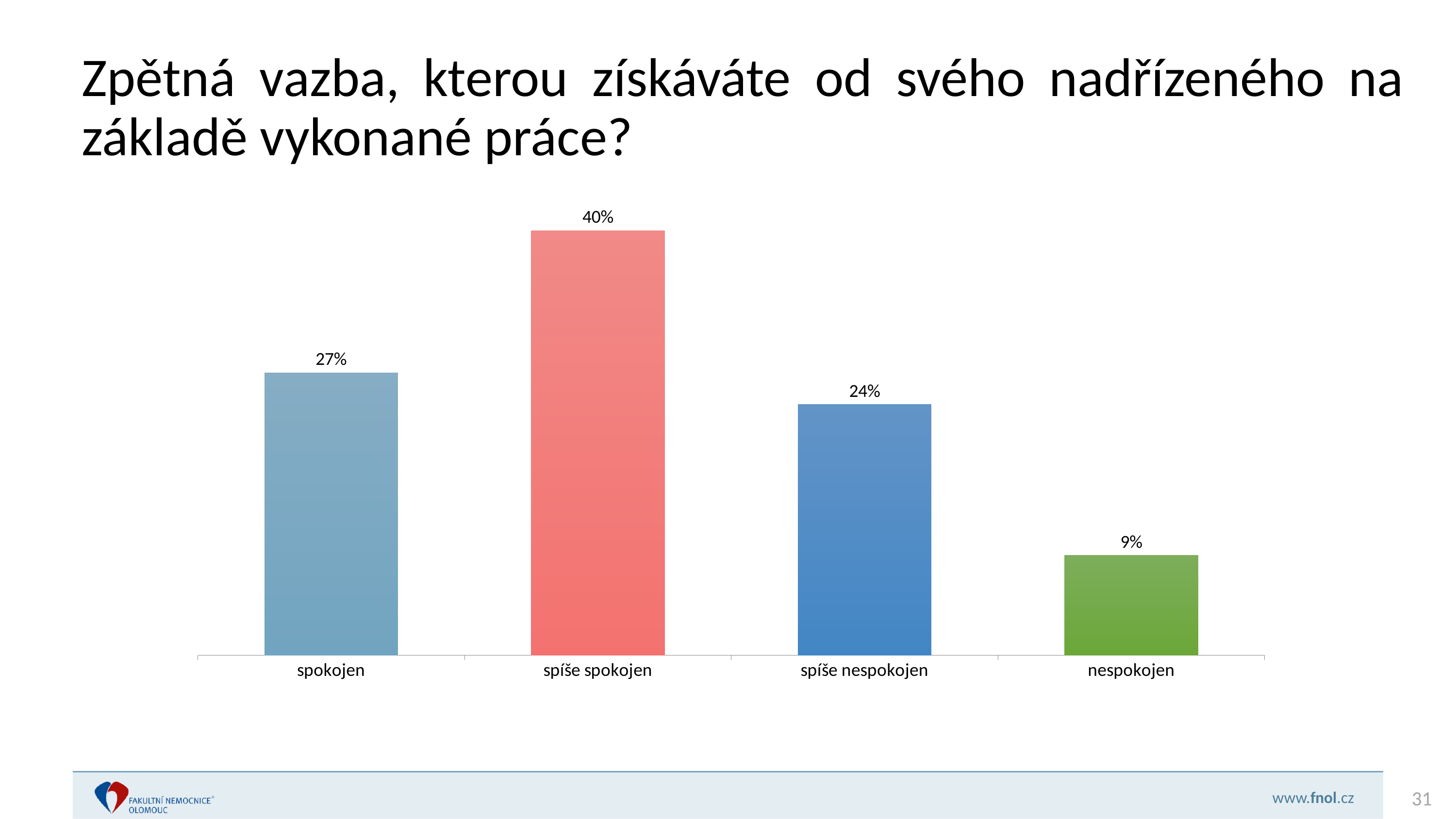
What kind of chart is shown on the slide? bar chart Which is larger, the value for "spokojen" or the value for "spíše nespokojen"? spokojen What is the value for "spíše nespokojen"? 24% What colour is the bar for "spíše spokojen"? red What is the value for "nespokojen"? 9% What is the difference between the values for "spíše nespokojen" and "nespokojen"? 15% What is the value for "spíše spokojen"? 40% Which category has the highest value? spíše spokojen How many categories are shown in the chart? 4 What is the value for "spokojen"? 27% What is the difference between the values for "spíše spokojen" and "spokojen"? 13% Which category has the lowest value? nespokojen